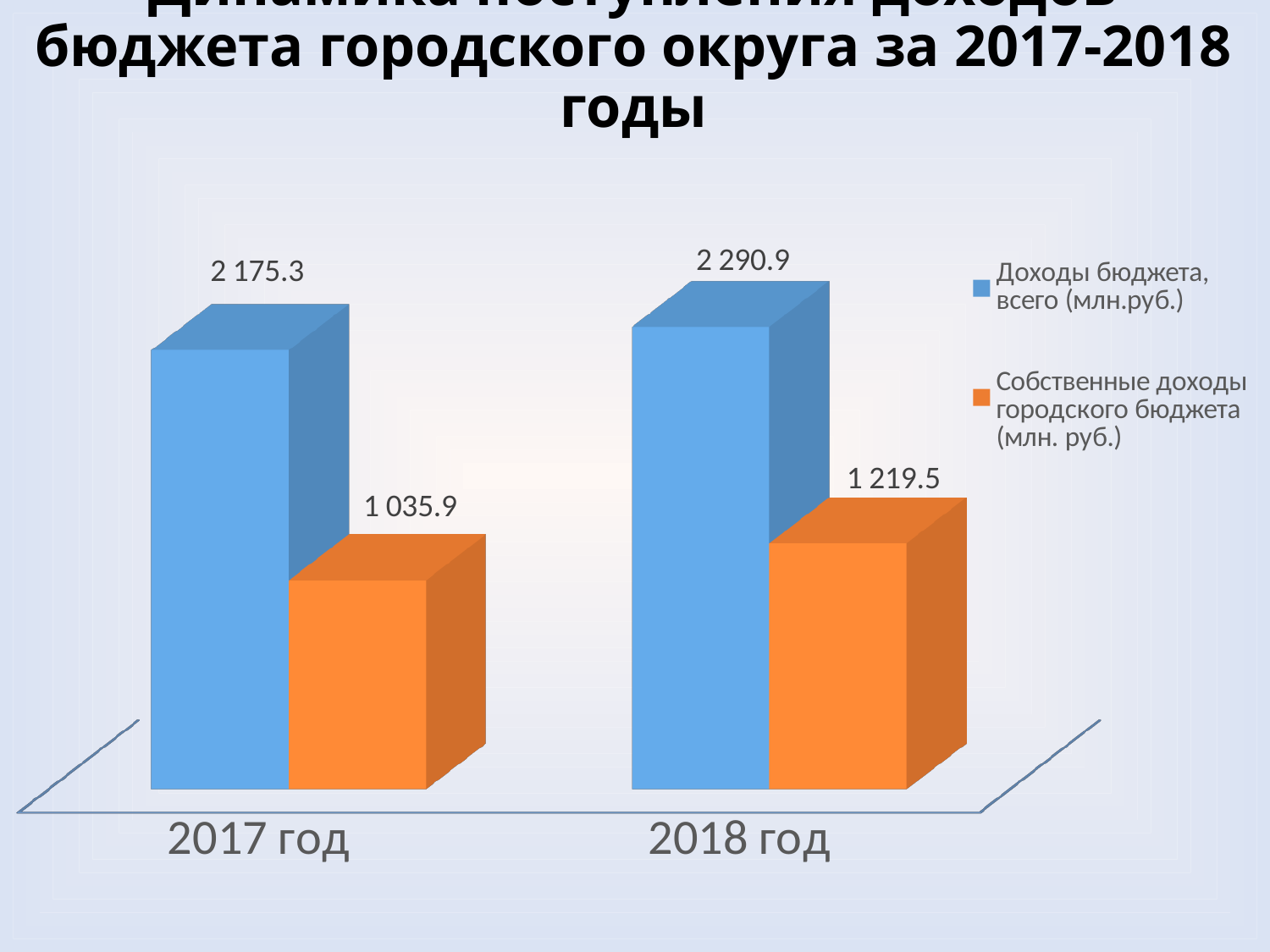
What kind of chart is shown on the slide? Bar chart What is the value of Собственные доходы городского бюджета (млн. руб.) for 2017 год? 1 035.9 What is the value of Доходы бюджета, всего (млн.руб.) for 2018 год? 2 290.9 What is the value of Собственные доходы городского бюджета (млн. руб.) for 2018 год? 1 219.5 What is the value of Доходы бюджета, всего (млн.руб.) for 2017 год? 2 175.3 How many years (categories) are shown on the x axis? 2 By how much did Доходы бюджета, всего (млн.руб.) increase from 2017 год to 2018 год? 115.6 Which is larger in 2018 год: Доходы бюджета, всего or Собственные доходы городского бюджета? Доходы бюджета, всего What is the difference between Доходы бюджета, всего and Собственные доходы городского бюджета in 2017 год? 1 139.4 In which year is Собственные доходы городского бюджета (млн. руб.) lowest? 2017 год How many series does the legend list? 2 In which year is Доходы бюджета, всего (млн.руб.) highest? 2018 год